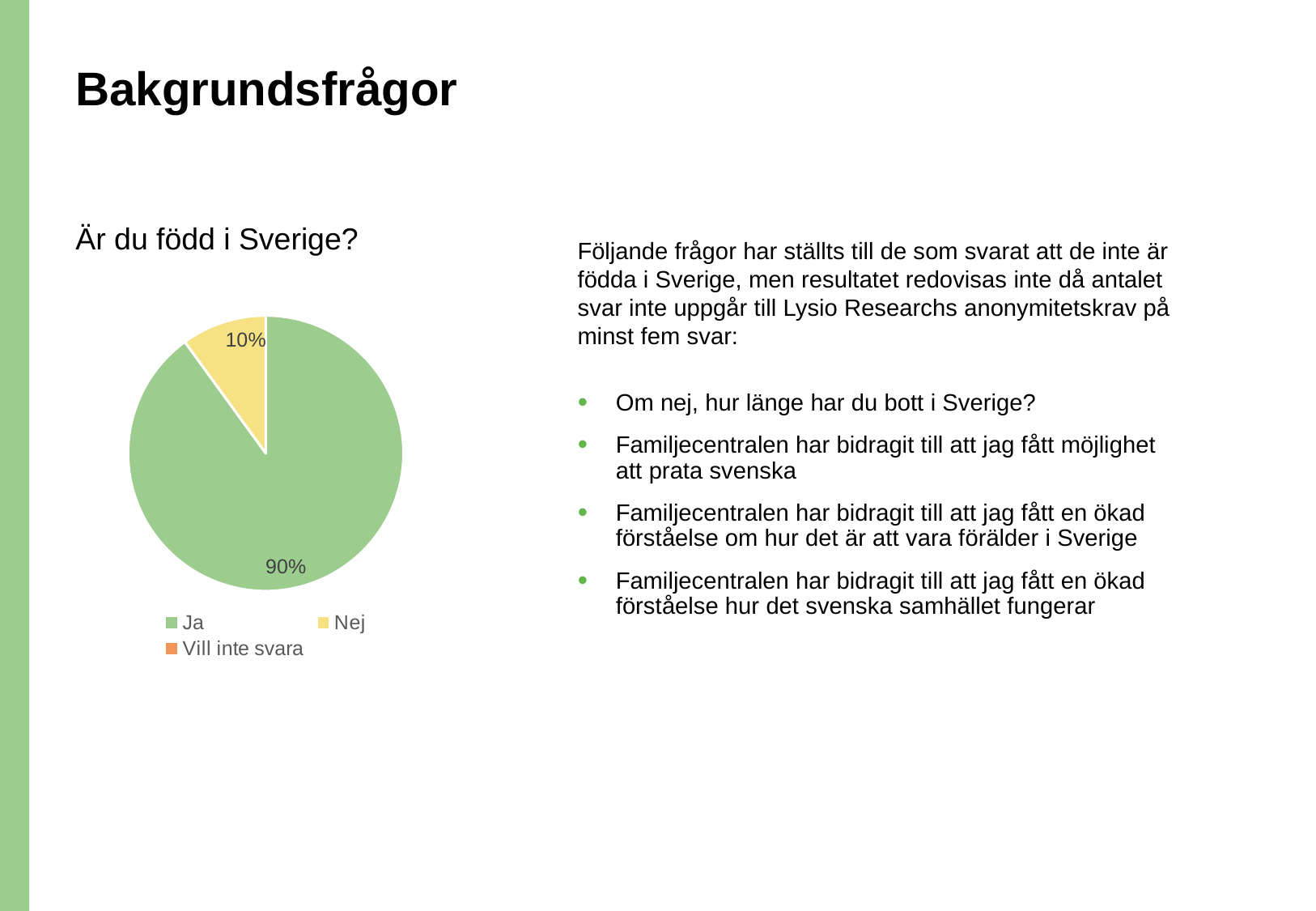
Which answer has the largest slice in the pie chart? Ja What kind of chart is shown on the slide? Pie chart How many slices with data labels are visible in the pie chart? 2 What colour is the "Nej" slice in the pie chart? Yellow How many entries does the legend of the pie chart list? 3 Which of the two visible slices is smaller, "Ja" or "Nej"? Nej Which is larger, the "Ja" slice or the "Nej" slice? Ja What share of respondents answered "Nej" to "Är du född i Sverige?"? 10% What share of respondents answered "Ja" to "Är du född i Sverige?"? 90% What is the title of the question shown above the pie chart? Är du född i Sverige? What is the difference in percentage points between the "Ja" and "Nej" slices? 80 percentage points